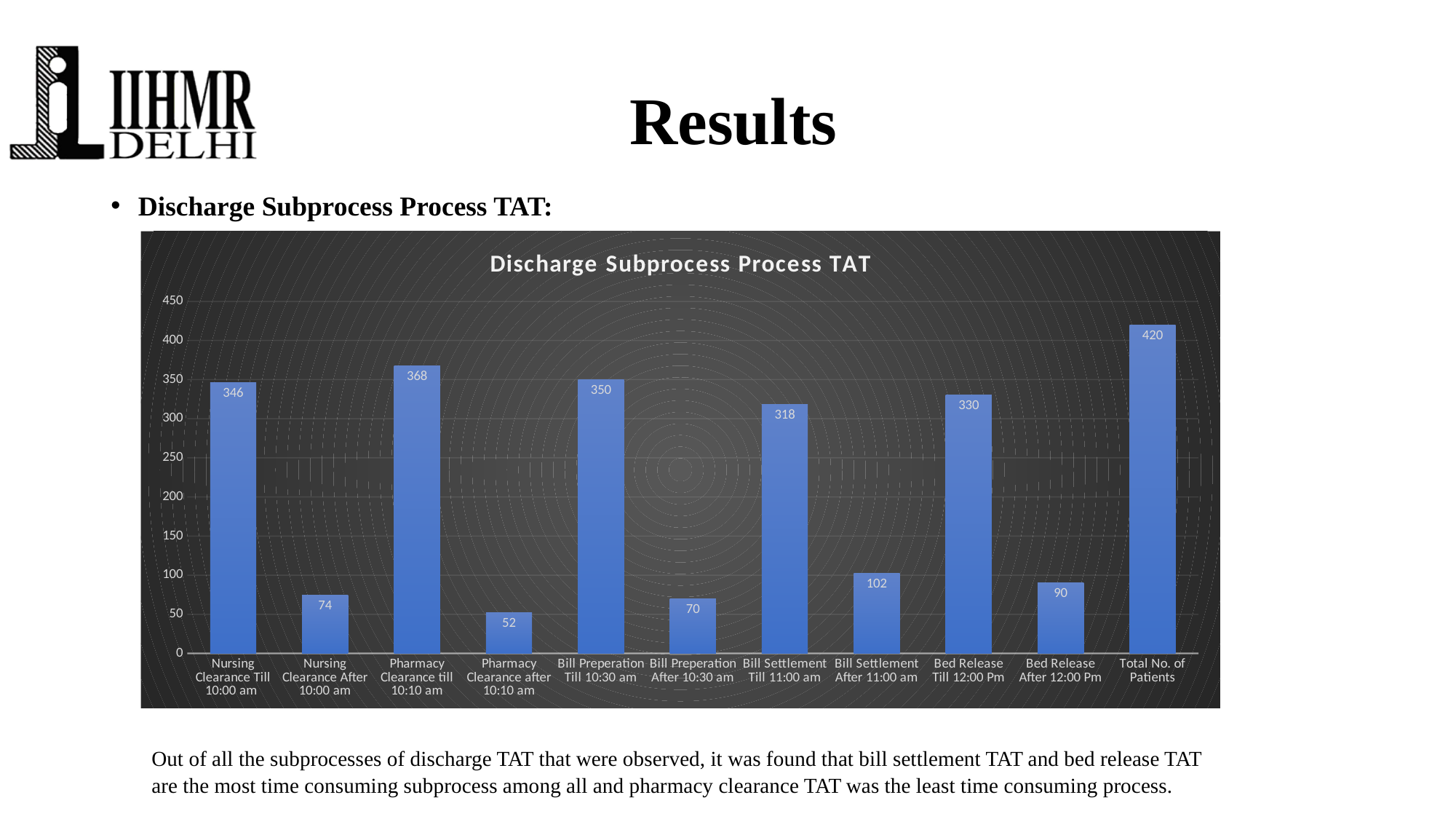
Which is larger, Bill Preperation Till 10:30 am or Bed Release Till 12:00 Pm? Bill Preperation Till 10:30 am What is the value for Bill Settlement After 11:00 am? 102 Is the value for Bill Settlement Till 11:00 am greater or less than 300? greater What kind of chart is this? Bar chart What is the difference between Pharmacy Clearance till 10:10 am and Pharmacy Clearance after 10:10 am? 316 How many categories are shown on the x axis? 11 What is the value for Nursing Clearance Till 10:00 am? 346 What is the value for Pharmacy Clearance after 10:10 am? 52 Which category has the lowest value? Pharmacy Clearance after 10:10 am What is the value for Total No. of Patients? 420 Which category has the highest value? Total No. of Patients What is the title of the chart? Discharge Subprocess Process TAT